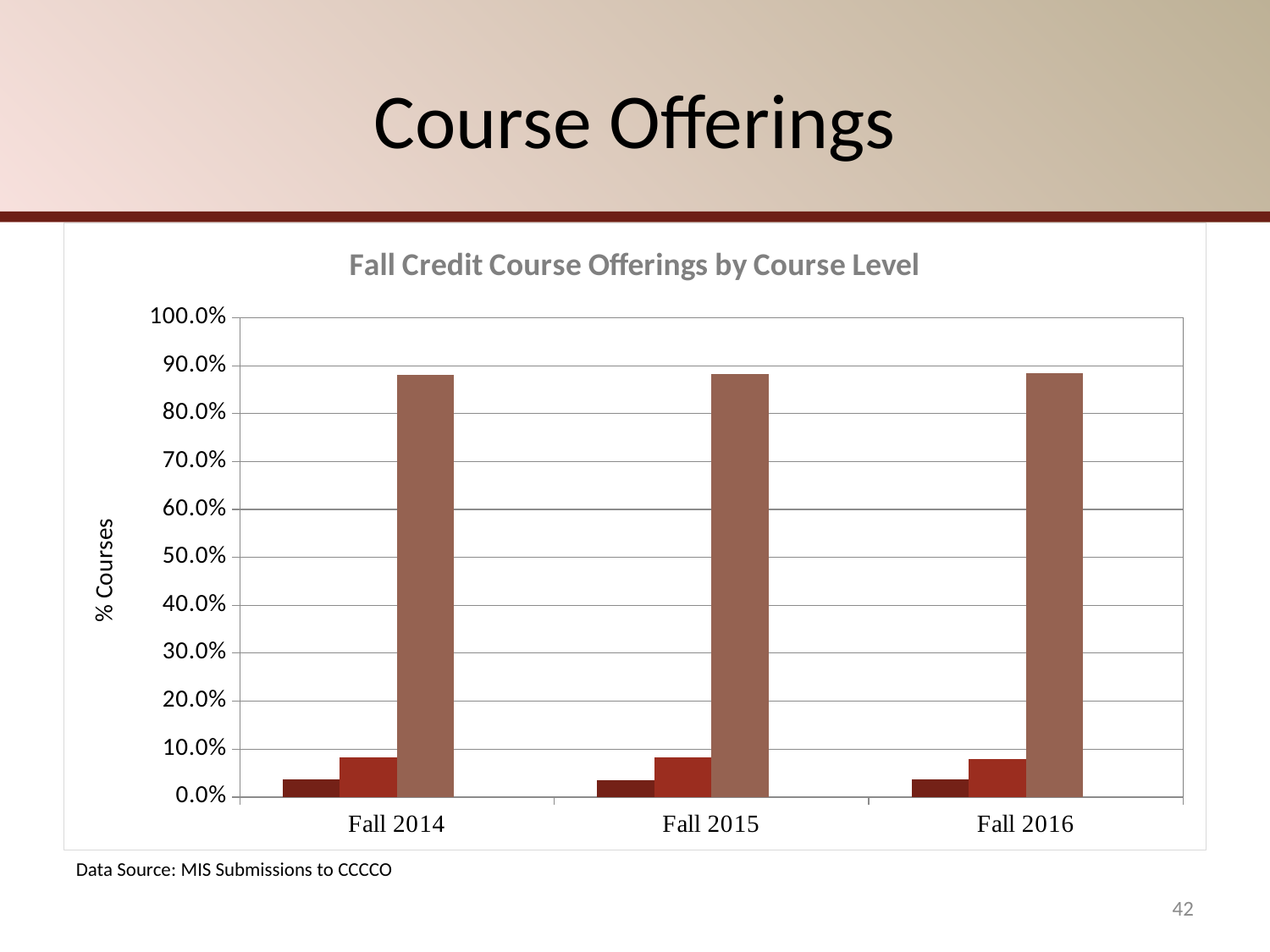
Is the value of the tallest (brown, rightmost) bar for Fall 2016 greater or less than 80%? greater Is the value of the tallest (brown, rightmost) bar for Fall 2015 greater or less than 90%? less Is the value of the red (middle) bar for Fall 2016 greater or less than 10%? less What type of chart is shown on the slide? bar chart For Fall 2014, which of the three bars is the shortest? the dark red (leftmost) bar What is the label on the vertical axis of the chart? % Courses For Fall 2015, which bar is larger: the dark red (leftmost) bar or the brown (rightmost) bar? the brown (rightmost) bar What is the title of the chart? Fall Credit Course Offerings by Course Level How many bars are plotted for each fall term in the chart? 3 How many fall terms are shown on the x axis of the chart? 3